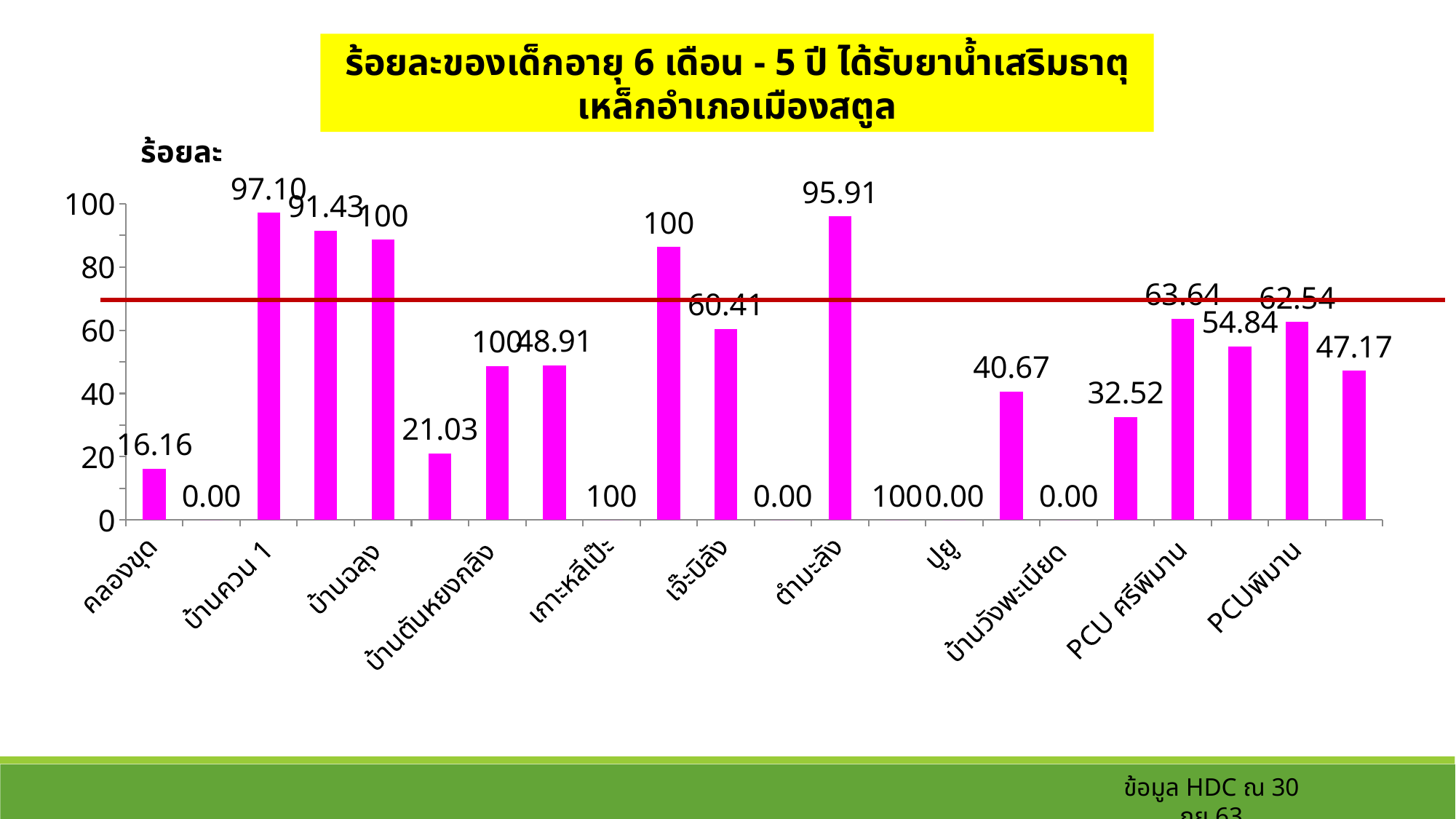
What is the value for คลองขุด? 16.16 Is the value for ตำมะลัง greater or less than 80? greater What is the value for PCUพิมาน? 62.54 What is the value for เจ๊ะบิลัง? 60.41 What is the value for บ้านวังพะเนียด? 0.00 What is the value for บ้านควน 1? 97.10 What kind of chart is shown on the slide? bar chart What is the value for PCU ศรีพิมาน? 63.64 What is the value for ตำมะลัง? 95.91 What is the difference between the values for บ้านควน 1 and คลองขุด? 80.94 Which is larger, the value for บ้านควน 1 or the value for ตำมะลัง? บ้านควน 1 What label is shown on the vertical axis of the chart? ร้อยละ